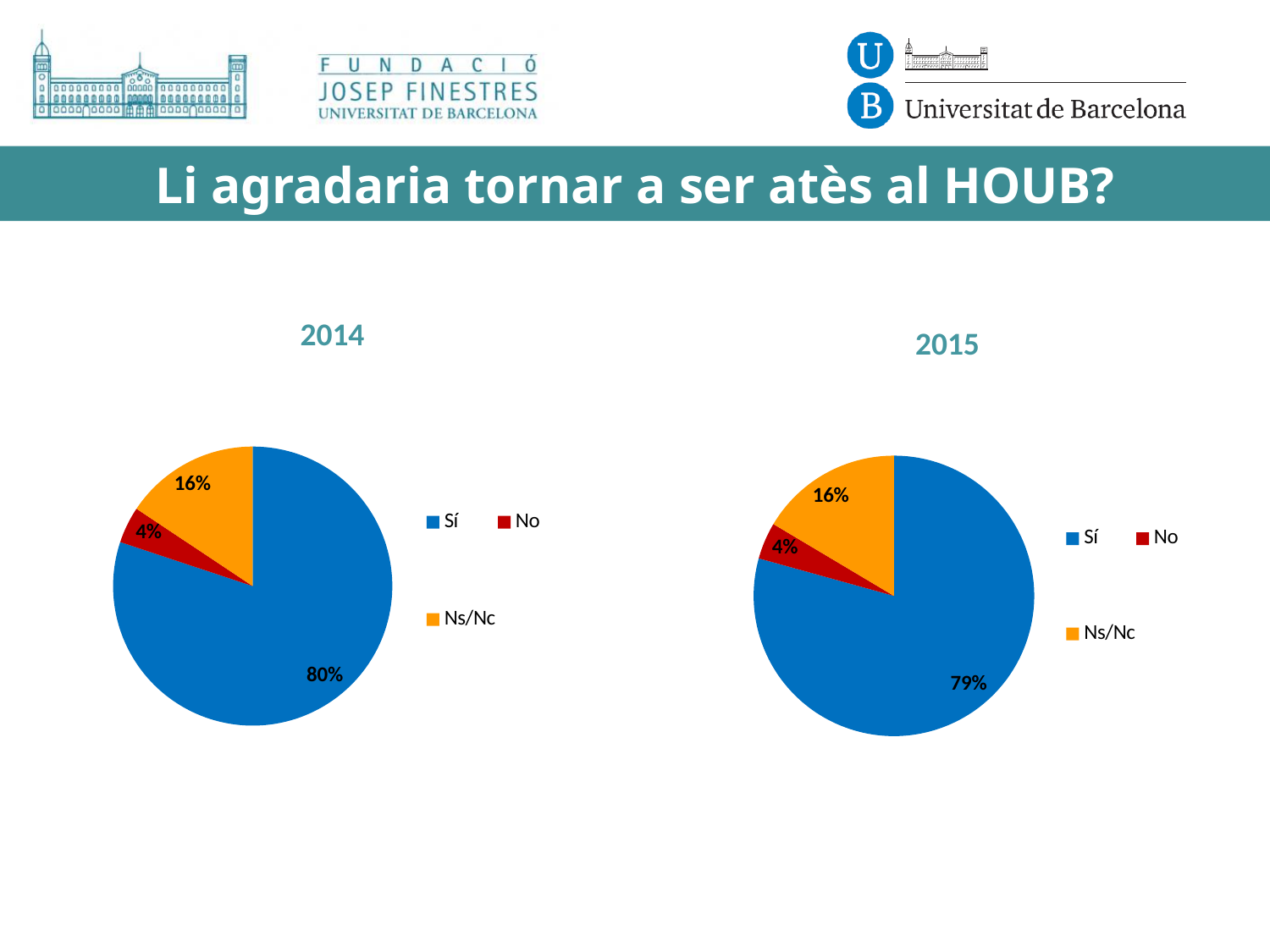
In the 2014 pie chart, what is the difference between the Sí share and the Ns/Nc share? 64% In the 2015 pie chart, what percentage of respondents answered Sí? 79% What type of chart is used for the 2014 data? pie chart In the 2014 pie chart, what share is labelled for Ns/Nc? 16% Is the Sí share larger in the 2014 chart or the 2015 chart? 2014 In the 2014 pie chart, what percentage of respondents answered Sí? 80% In the 2015 pie chart, is the Ns/Nc slice larger or smaller than the No slice? larger How many categories does the legend of the 2015 pie chart list? 3 In the 2015 pie chart, what share is labelled for No? 4% In the 2014 pie chart, which category has the largest slice? Sí In the 2015 pie chart, which category has the smallest slice? No In the 2014 pie chart, what colour is the Ns/Nc slice? orange